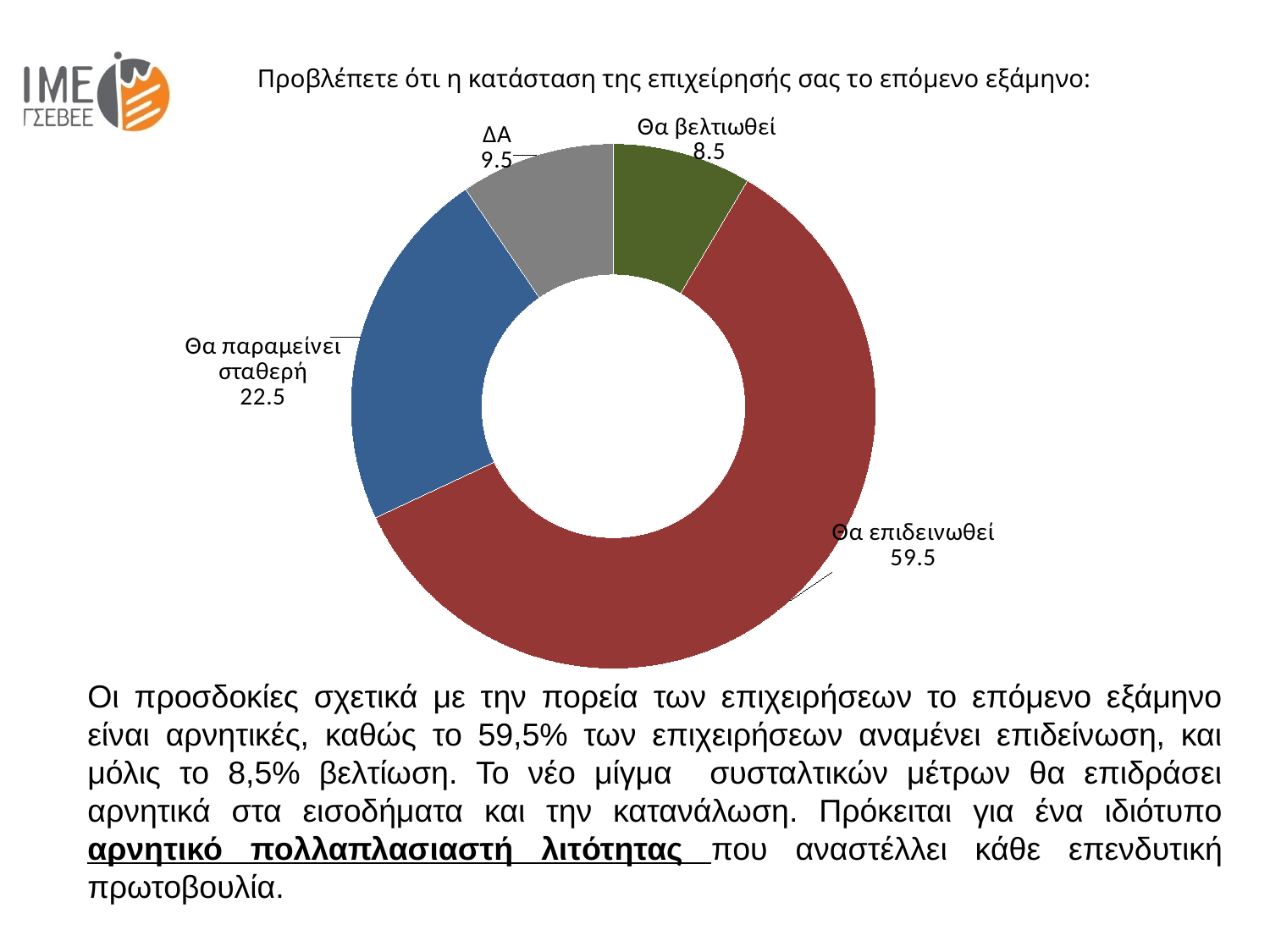
Which category has the smallest slice? Θα βελτιωθεί What is the difference between the values for 'ΔΑ' and 'Θα βελτιωθεί'? 1 What value is shown for the 'Θα βελτιωθεί' slice? 8.5 What value is shown for the 'Θα παραμείνει σταθερή' slice? 22.5 Which category has the largest slice? Θα επιδεινωθεί What is the difference between the values for 'Θα επιδεινωθεί' and 'Θα παραμείνει σταθερή'? 37 What is the title of the chart? Προβλέπετε ότι η κατάσταση της επιχείρησής σας το επόμενο εξάμηνο: Which is larger, the value for 'Θα παραμείνει σταθερή' or the value for 'ΔΑ'? Θα παραμείνει σταθερή What value is shown for the 'Θα επιδεινωθεί' slice? 59.5 How many categories are shown in the chart? 4 What kind of chart is shown on the slide? Doughnut (pie) chart What value is shown for the 'ΔΑ' slice? 9.5